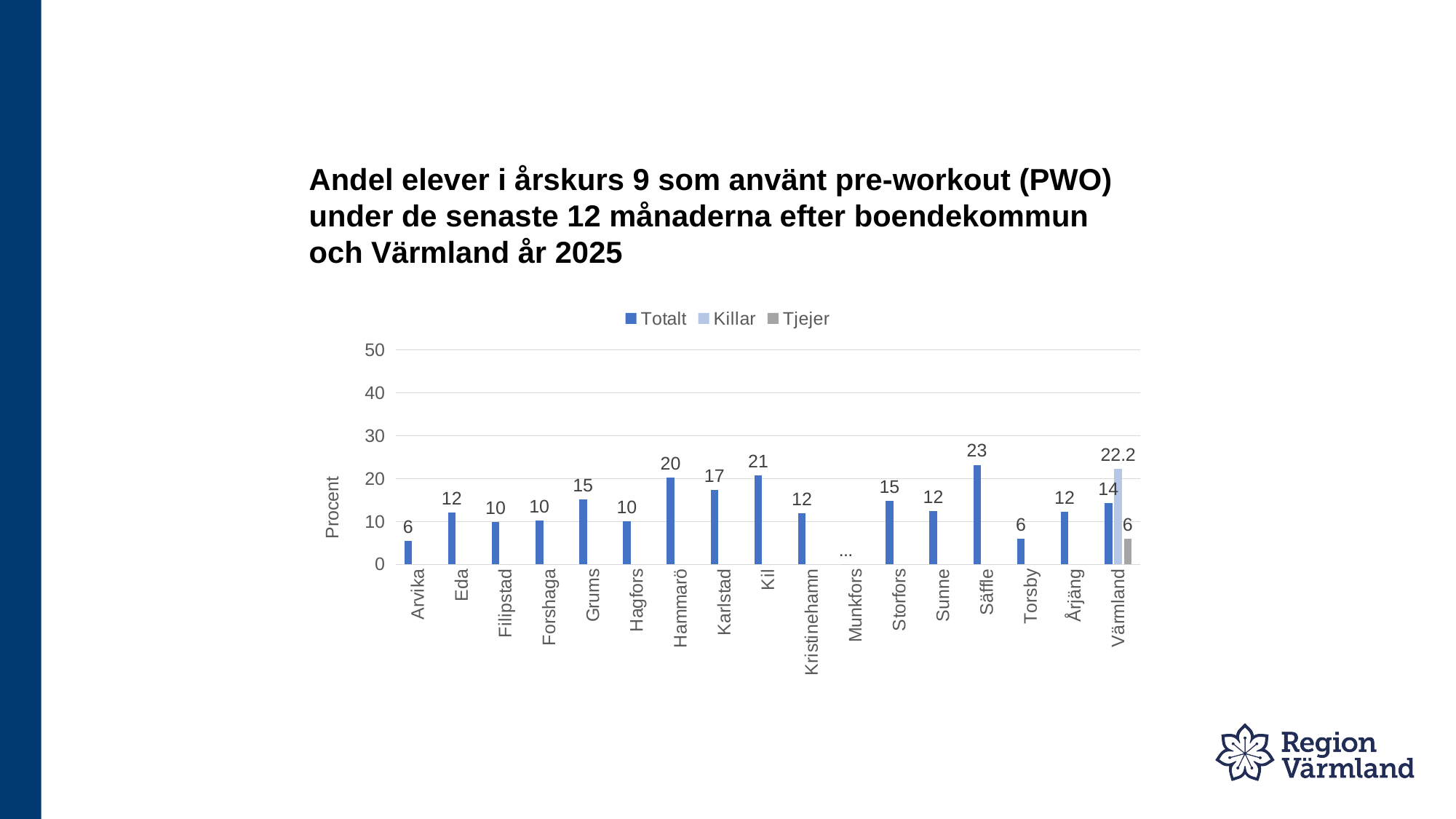
What is the Killar value for Värmland? 22.2 Which municipality has the highest Totalt value? Säffle What is the difference between the Totalt values for Säffle and Arvika? 17 What kind of chart is shown on the slide? bar chart What is the difference between the Killar and Tjejer values for Värmland? 16.2 Which has a larger Totalt value, Hammarö or Karlstad? Hammarö What is the Tjejer value for Värmland? 6 What is the Totalt value for Säffle? 23 What is the Totalt value for Hammarö? 20 Is the Totalt value for Kil greater or less than 20? greater How many series does the legend list? 3 What is the label on the vertical axis? Procent